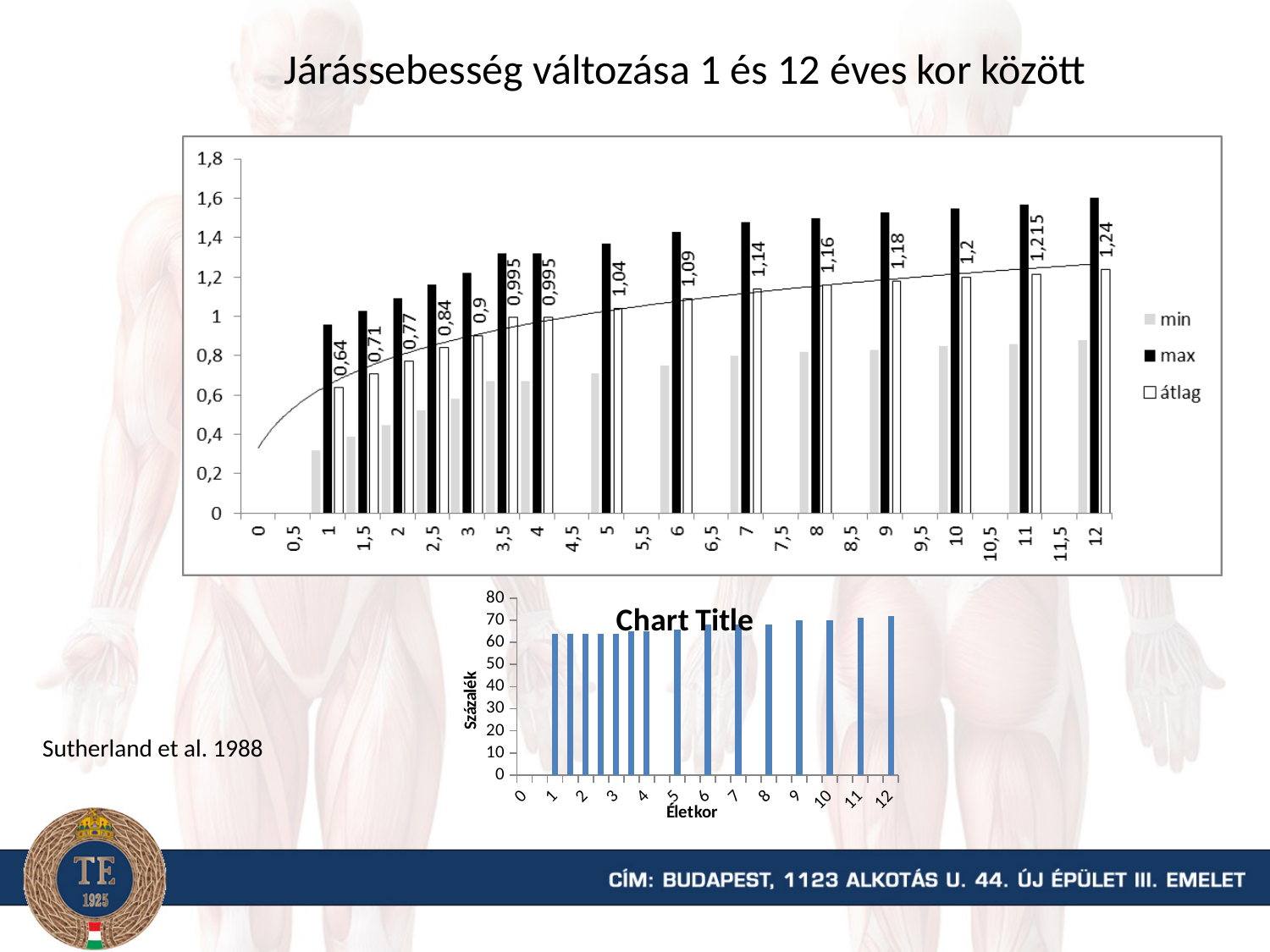
In the top chart, what is the átlag value at age 7? 1,14 In the top chart, which age has the lowest átlag value? 1 In the top chart, is the max value at age 12 greater or less than 1,4? greater What kind of chart is the bottom chart titled 'Chart Title'? bar chart In the top chart, how many series does the legend list? 3 In the top chart, what is the átlag value at age 1? 0,64 In the top chart, what is the átlag value at age 11? 1,215 In the top chart, what is the difference between the átlag values at age 12 and age 1? 0,6 In the bottom chart titled 'Chart Title', is the value at age 1 greater or less than 60? greater In the top chart, which age has the highest átlag value? 12 In the top chart, what is the átlag value at age 12? 1,24 In the top chart, do the átlag values rise or fall as age increases? rise